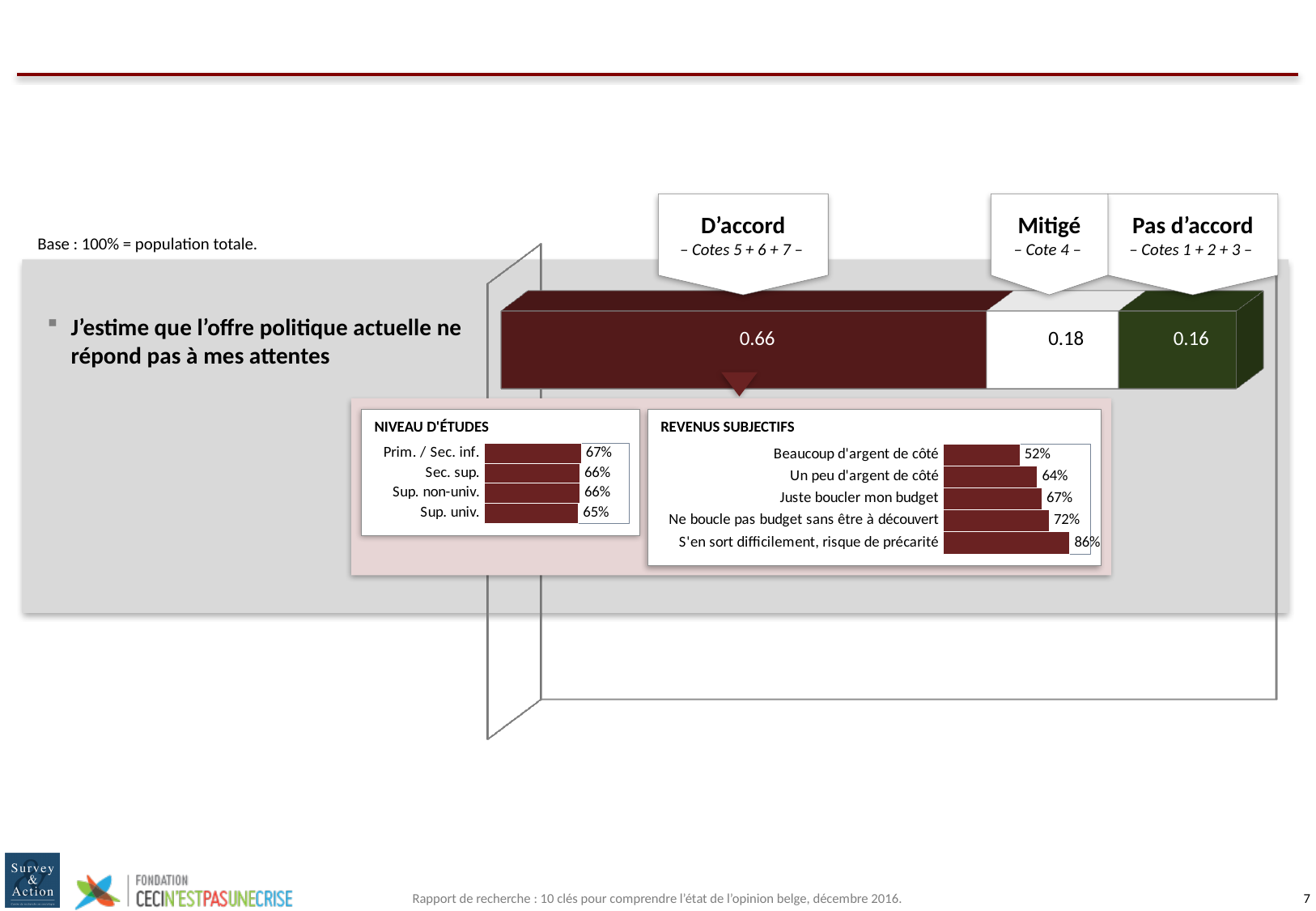
In the 'REVENUS SUBJECTIFS' chart, which category has the lowest value? Beaucoup d'argent de côté How many categories are shown in the 'NIVEAU D'ÉTUDES' chart? 4 In the 'NIVEAU D'ÉTUDES' chart, which category has the highest value? Prim. / Sec. inf. In the 'REVENUS SUBJECTIFS' chart, what is the difference between 'S'en sort difficilement, risque de précarité' and 'Beaucoup d'argent de côté'? 34% In the 'REVENUS SUBJECTIFS' chart, what is the value for 'Ne boucle pas budget sans être à découvert'? 72% In the main stacked bar chart, what is the value for 'D'accord'? 0.66 In the 'NIVEAU D'ÉTUDES' chart, what is the value for 'Sup. univ.'? 65% What kind of chart is the 'REVENUS SUBJECTIFS' chart? bar chart In the main stacked bar chart, what is the total of the three segments? 1.00 In the main stacked bar chart, what is the value for 'Mitigé'? 0.18 In the 'REVENUS SUBJECTIFS' chart, do the values rise or fall going from 'Beaucoup d'argent de côté' down to 'S'en sort difficilement, risque de précarité'? rise In the main stacked bar chart, what is the value for 'Pas d'accord'? 0.16